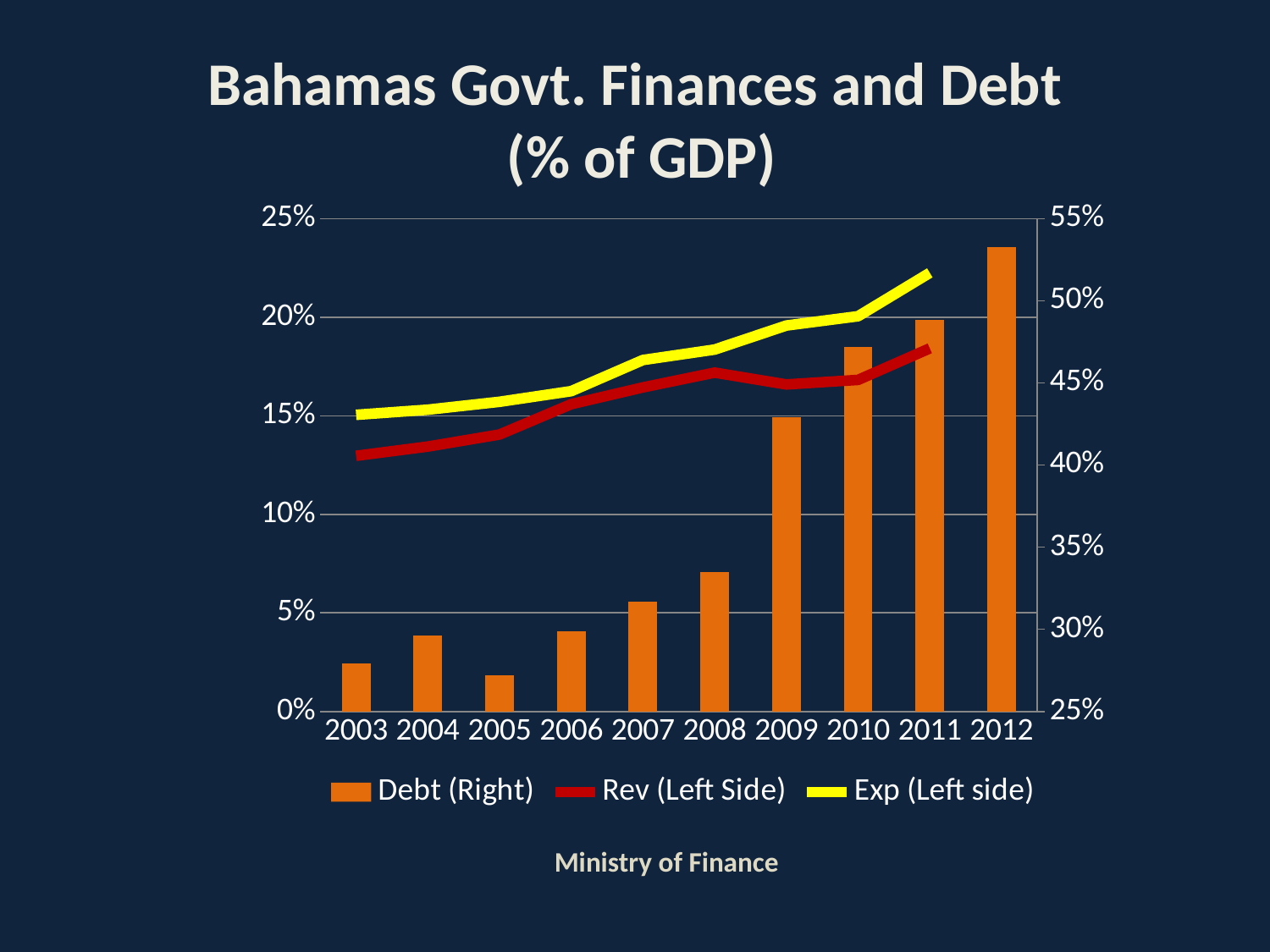
Which year has the lowest Debt bar? 2005 In 2008, which is higher, Exp or Rev? Exp Is the Debt value for 2009 greater or less than 40%? greater Is the Exp value for 2011 greater or less than 20%? greater What kind of chart is shown on the slide? A combination bar and line chart Does the Exp line rise or fall from 2003 to 2011? Rise Is the Debt value for 2003 greater or less than 30%? less Which year has the highest Debt bar? 2012 How many years are shown on the x axis? 10 How many series does the legend list? 3